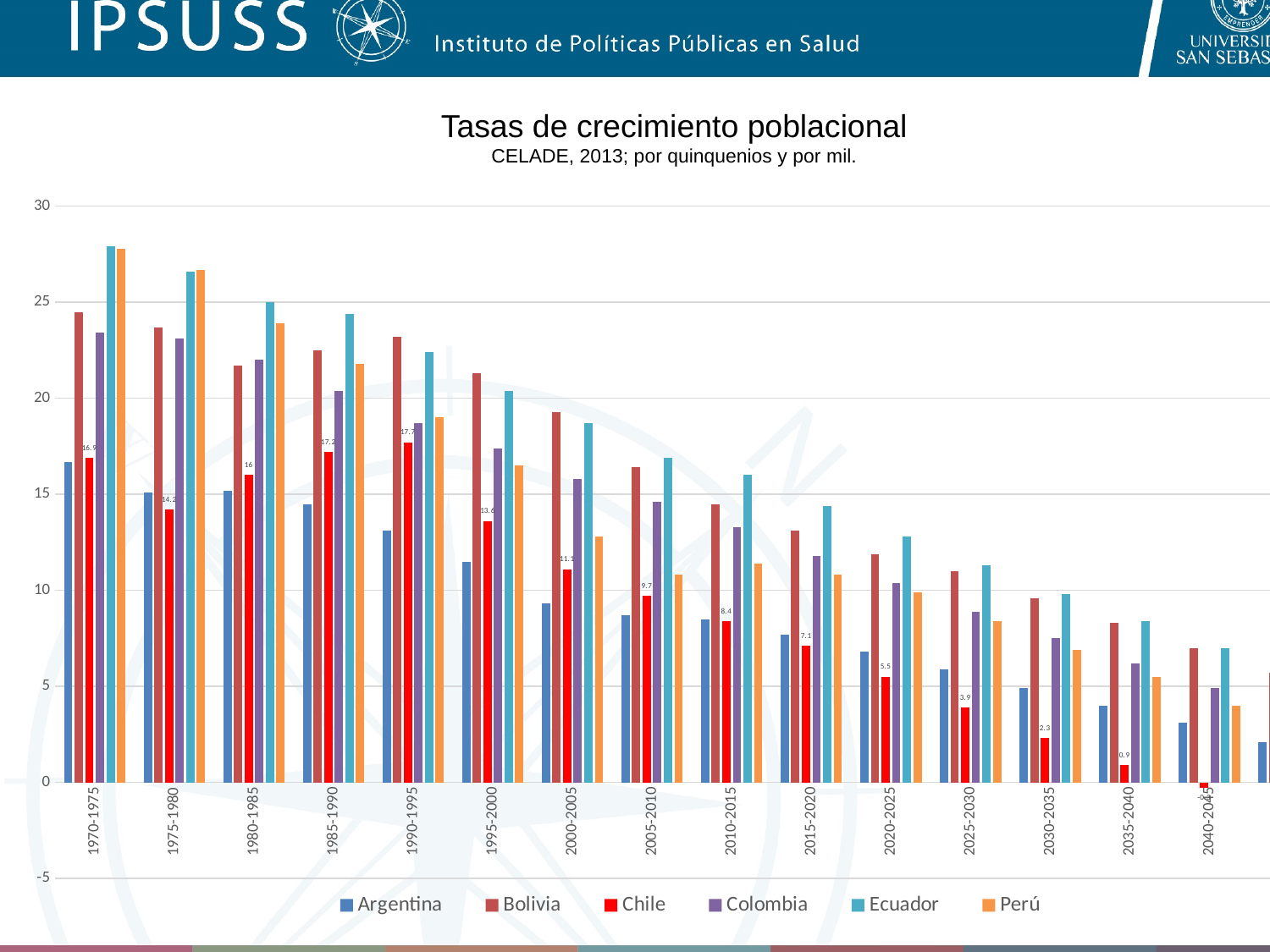
In which period does Chile have its highest value? 1990-1995 What is the value for Chile in 2005-2010? 9.7 How many series does the legend list? 6 Is the value for Argentina in 2040-2045 greater or less than 5? less What is the value for Chile in 1970-1975? 16.9 What kind of chart is shown on the slide? bar chart Do the values for Chile rise or fall from 1990-1995 to 2035-2040? fall Is the value for Ecuador in 1970-1975 greater or less than 25? greater What is the value for Chile in 2035-2040? 0.9 What is the difference between the Chile values for 1985-1990 and 2000-2005? 6.1 What is the value for Chile in 1990-1995? 17.7 In 1970-1975, which is larger, the value for Bolivia or the value for Argentina? Bolivia